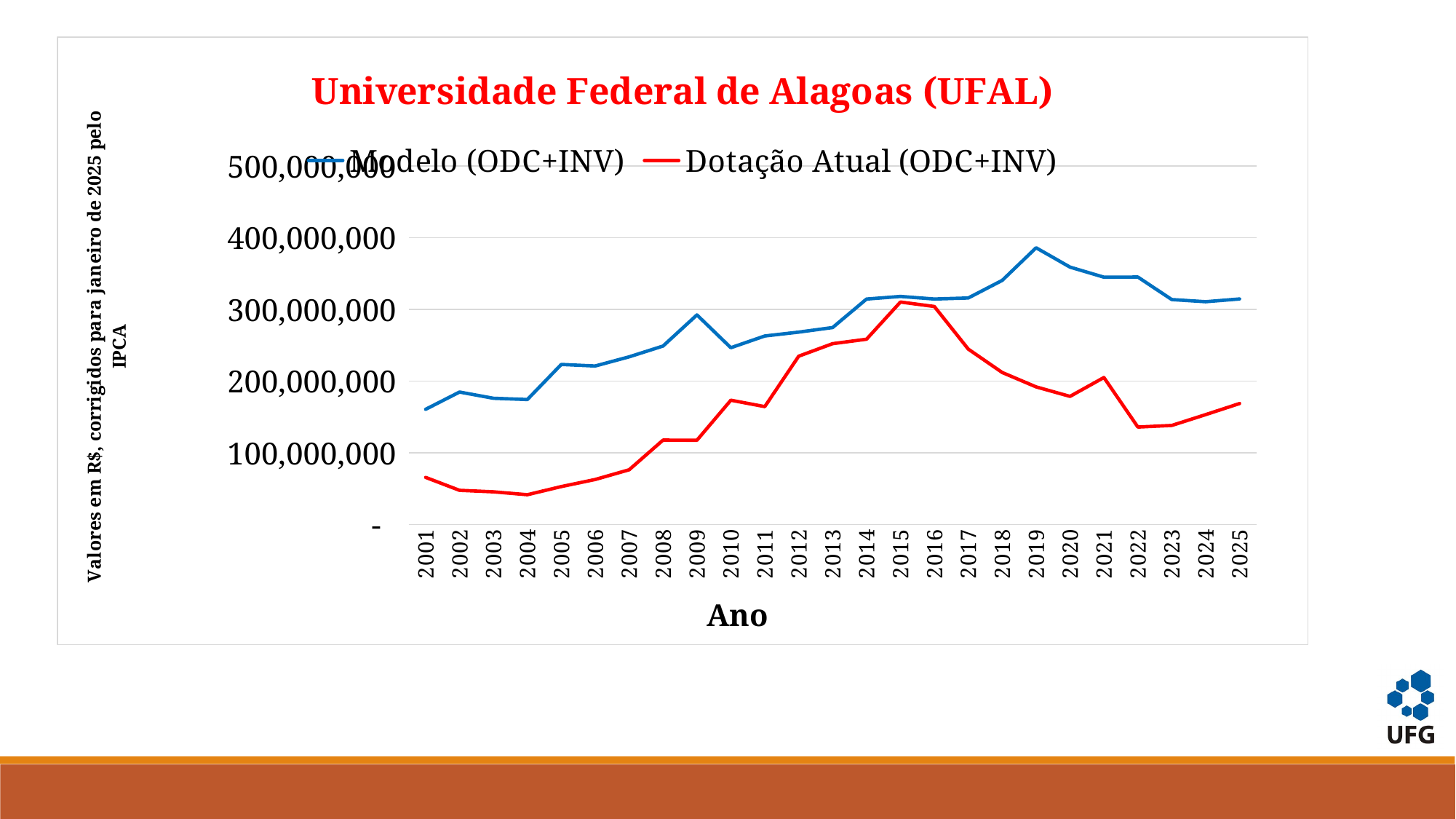
Is the value for Modelo (ODC+INV) in 2019 greater or less than 300,000,000? greater Is the value for Dotação Atual (ODC+INV) in 2004 greater or less than 100,000,000? less In 2010, which series has the larger value, Modelo (ODC+INV) or Dotação Atual (ODC+INV)? Modelo (ODC+INV) In which year is the Modelo (ODC+INV) series at its lowest? 2001 Does the Dotação Atual (ODC+INV) series rise or fall from 2016 to 2022? fall How many series does the legend list? 2 In which year is the Dotação Atual (ODC+INV) series at its lowest? 2004 What kind of chart is shown on the slide? line chart How many years are plotted along the x axis? 25 In which year does the Modelo (ODC+INV) series reach its highest value? 2019 Is the value for Dotação Atual (ODC+INV) in 2022 greater or less than 200,000,000? less What is the title of the chart? Universidade Federal de Alagoas (UFAL)